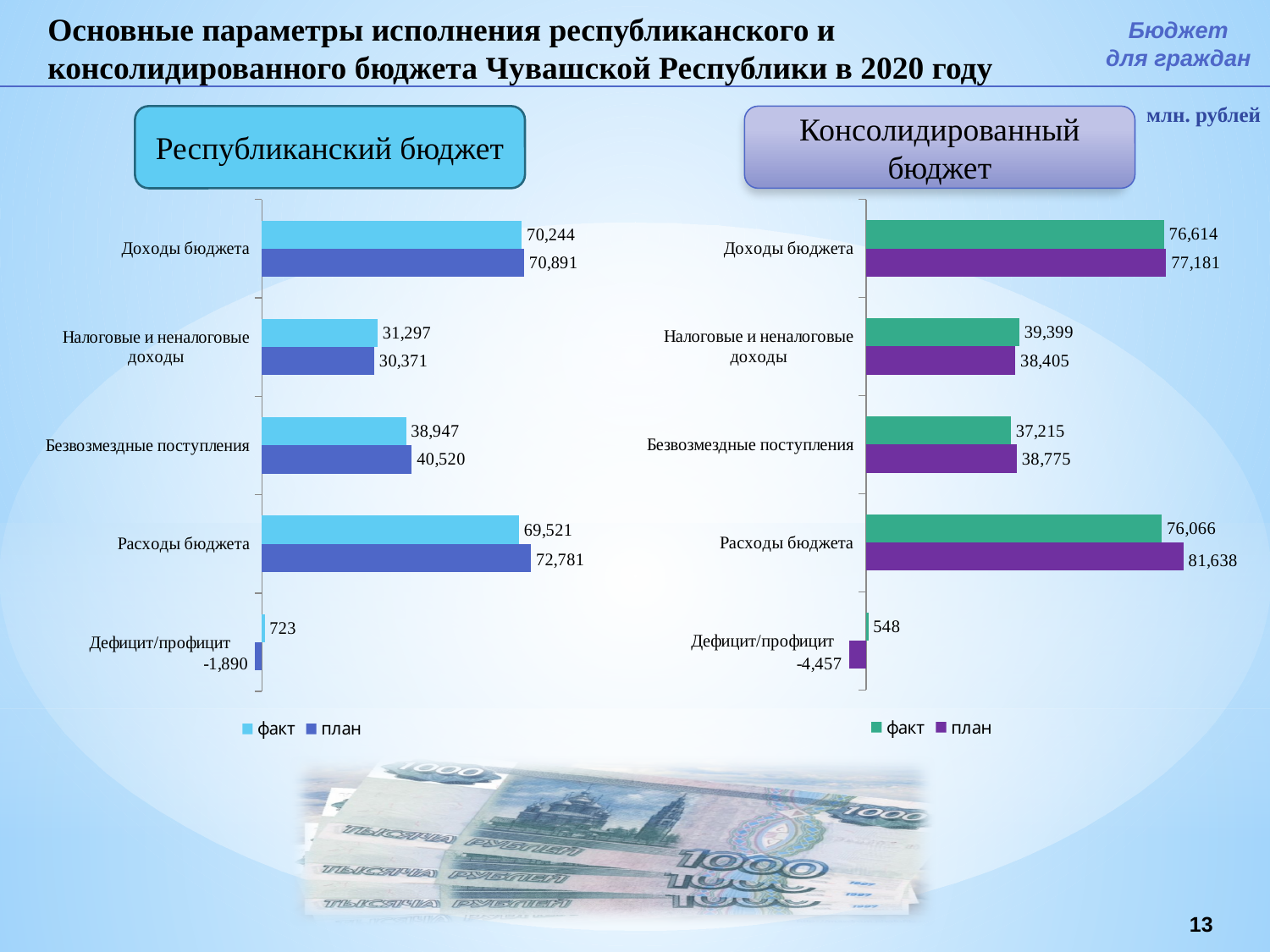
In the 'Консолидированный бюджет' chart, what is the план value for Расходы бюджета? 81,638 In the 'Республиканский бюджет' chart, what is the план value for Дефицит/профицит? -1,890 In the 'Республиканский бюджет' chart, what is the факт value for Доходы бюджета? 70,244 In the 'Консолидированный бюджет' chart, what is the difference between the план and факт values for Расходы бюджета? 5,572 In the 'Республиканский бюджет' chart, which is larger for Безвозмездные поступления: факт or план? план In the 'Республиканский бюджет' chart, what is the difference between the план and факт values for Расходы бюджета? 3,260 In the 'Республиканский бюджет' chart, what is the план value for Расходы бюджета? 72,781 What type of chart is the 'Республиканский бюджет' chart? Bar chart In the 'Консолидированный бюджет' chart, what is the факт value for Налоговые и неналоговые доходы? 39,399 How many categories are shown in the 'Республиканский бюджет' chart? 5 In the 'Консолидированный бюджет' chart, which category has the highest план value? Расходы бюджета How many series does the legend of the 'Консолидированный бюджет' chart list? 2